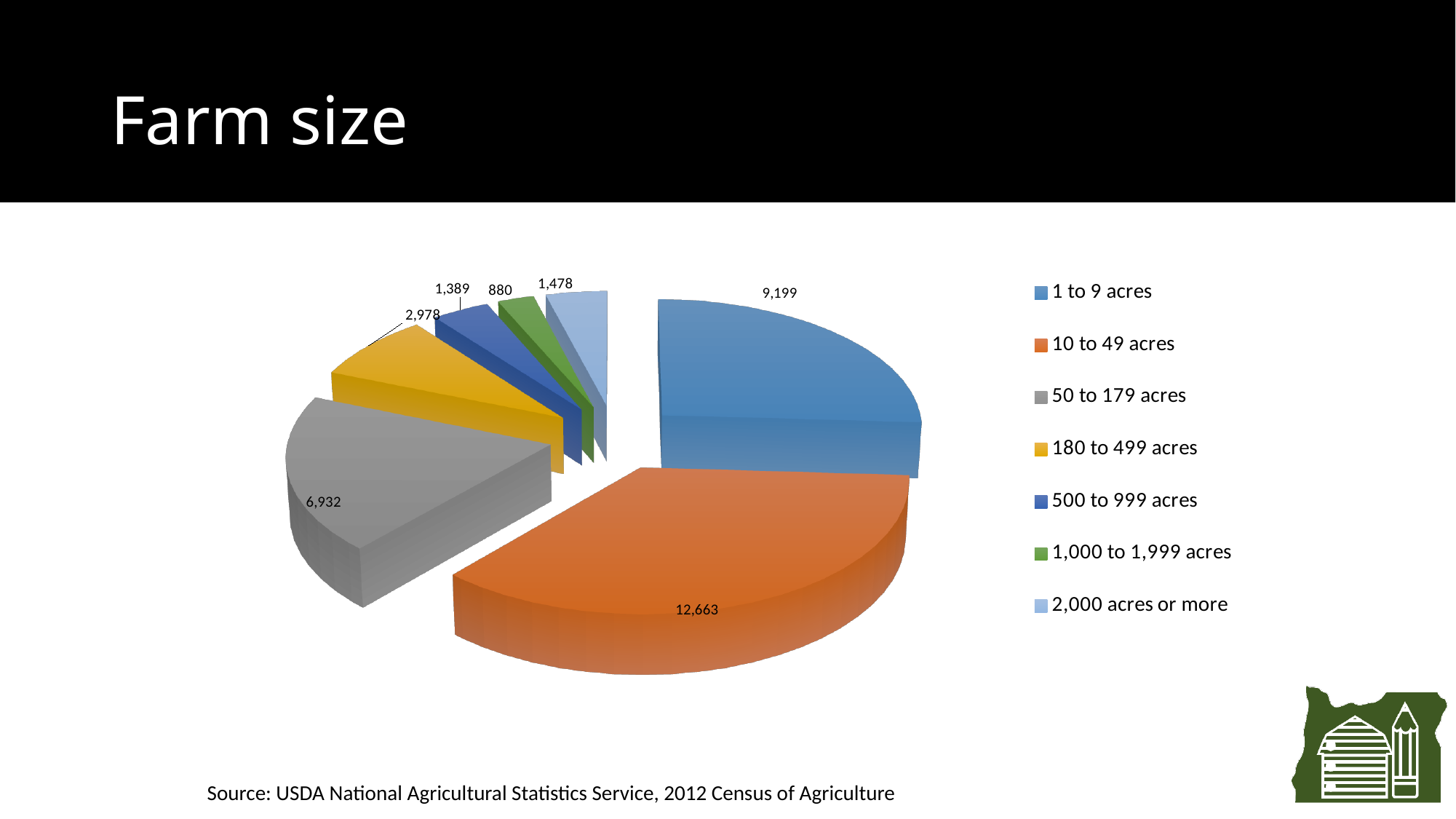
Which farm-size category has the smallest slice? 1,000 to 1,999 acres What is the difference between the 10 to 49 acres value and the 1 to 9 acres value? 3,464 Which farm-size category has the largest slice? 10 to 49 acres What is the value for the 2,000 acres or more slice? 1,478 What kind of chart is shown on the slide? Pie chart Which is larger, the 180 to 499 acres slice or the 500 to 999 acres slice? 180 to 499 acres How many farm-size categories does the pie chart show? 7 What is the value for the 1 to 9 acres slice? 9,199 What is the title of the slide containing the pie chart? Farm size What is the value for the 10 to 49 acres slice? 12,663 What is the value for the 50 to 179 acres slice? 6,932 What is the difference between the 2,000 acres or more value and the 500 to 999 acres value? 89